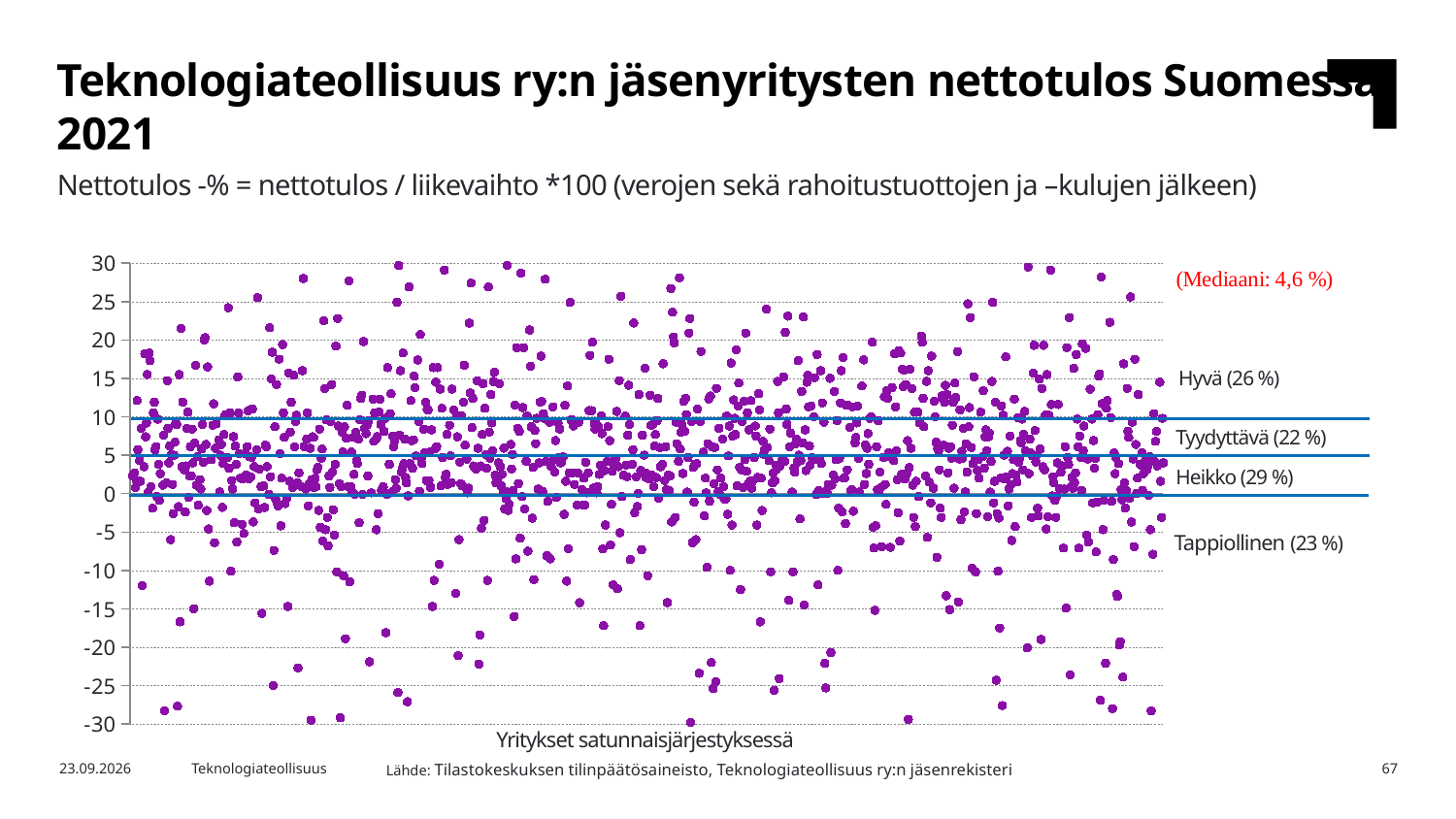
Which of the four categories (Hyvä, Tyydyttävä, Heikko, Tappiollinen) has the smallest share of companies? Tyydyttävä Which category has a larger share of companies, 'Hyvä' or 'Tappiollinen'? Hyvä What share of companies falls into the 'Tappiollinen' category? 23 % What is the median net profit percentage stated on the chart? 4,6 % What is the difference in percentage points between the share of 'Heikko' companies and the share of 'Tyydyttävä' companies? 7 Which of the four categories (Hyvä, Tyydyttävä, Heikko, Tappiollinen) has the largest share of companies? Heikko What share of companies falls into the 'Hyvä' category? 26 % At which y-axis values are the three horizontal blue lines drawn on the chart? 10, 5 and 0 What share of companies falls into the 'Heikko' category? 29 % What is the label of the x axis of the chart? Yritykset satunnaisjärjestyksessä What share of companies falls into the 'Tyydyttävä' category? 22 % What kind of chart is shown on the slide? Scatter chart